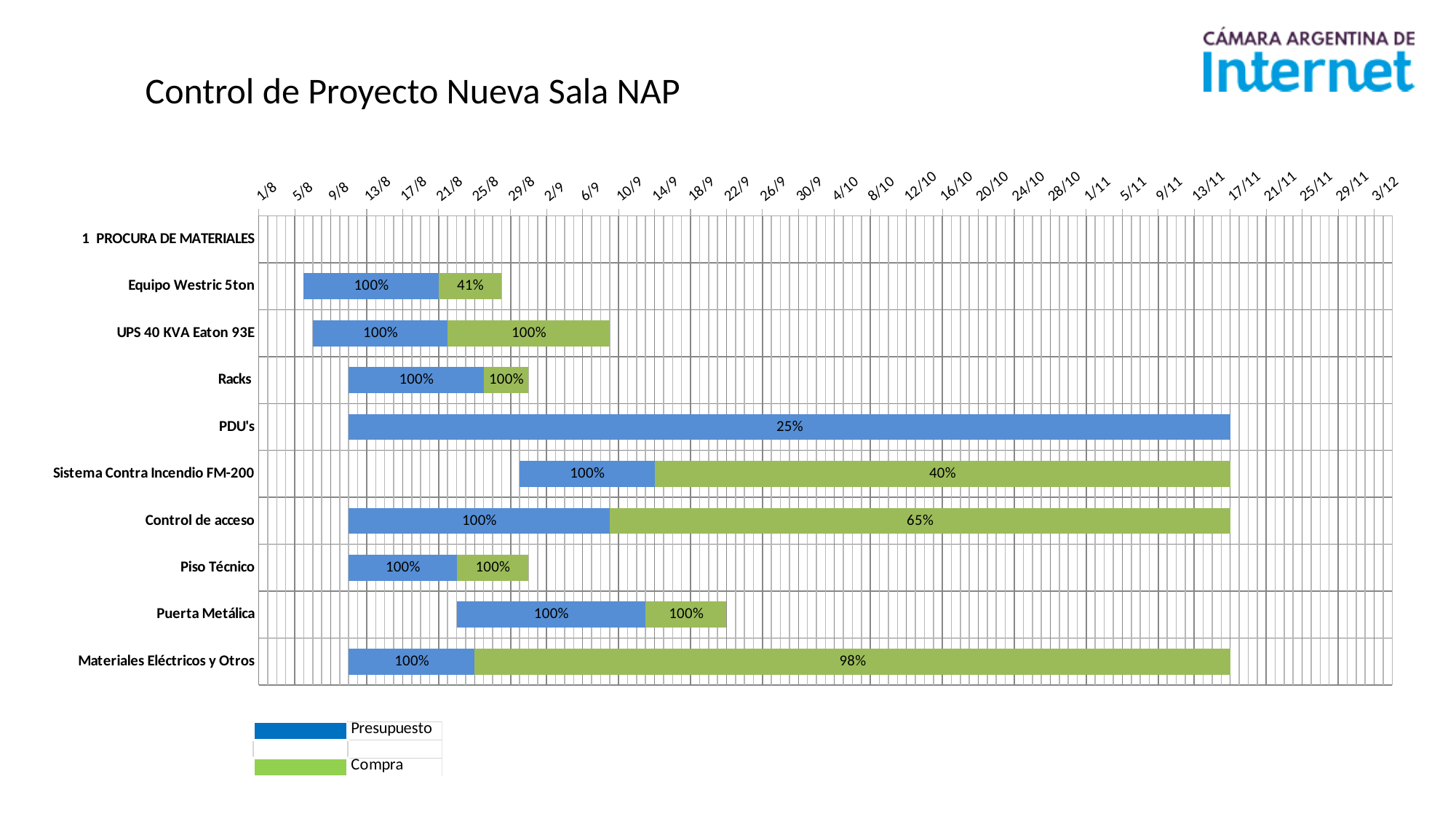
Which task has the lowest Compra percentage? Sistema Contra Incendio FM-200 What is the title of the slide containing the chart? Control de Proyecto Nueva Sala NAP How many tasks have bars plotted on the chart? 9 What percentage is shown on the Compra bar for Materiales Eléctricos y Otros? 98% What percentage is shown on the Compra bar for Equipo Westric 5ton? 41% Which task has the lowest Presupuesto percentage? PDU's How many series does the legend list? 2 What percentage is shown on the Presupuesto bar for PDU's? 25% Which is larger, the Compra percentage for Control de acceso or for Sistema Contra Incendio FM-200? Control de acceso What is the difference between the Compra percentage for Control de acceso and for Sistema Contra Incendio FM-200? 25% What percentage is shown on the Compra bar for Sistema Contra Incendio FM-200? 40% What percentage is shown on the Compra bar for Control de acceso? 65%